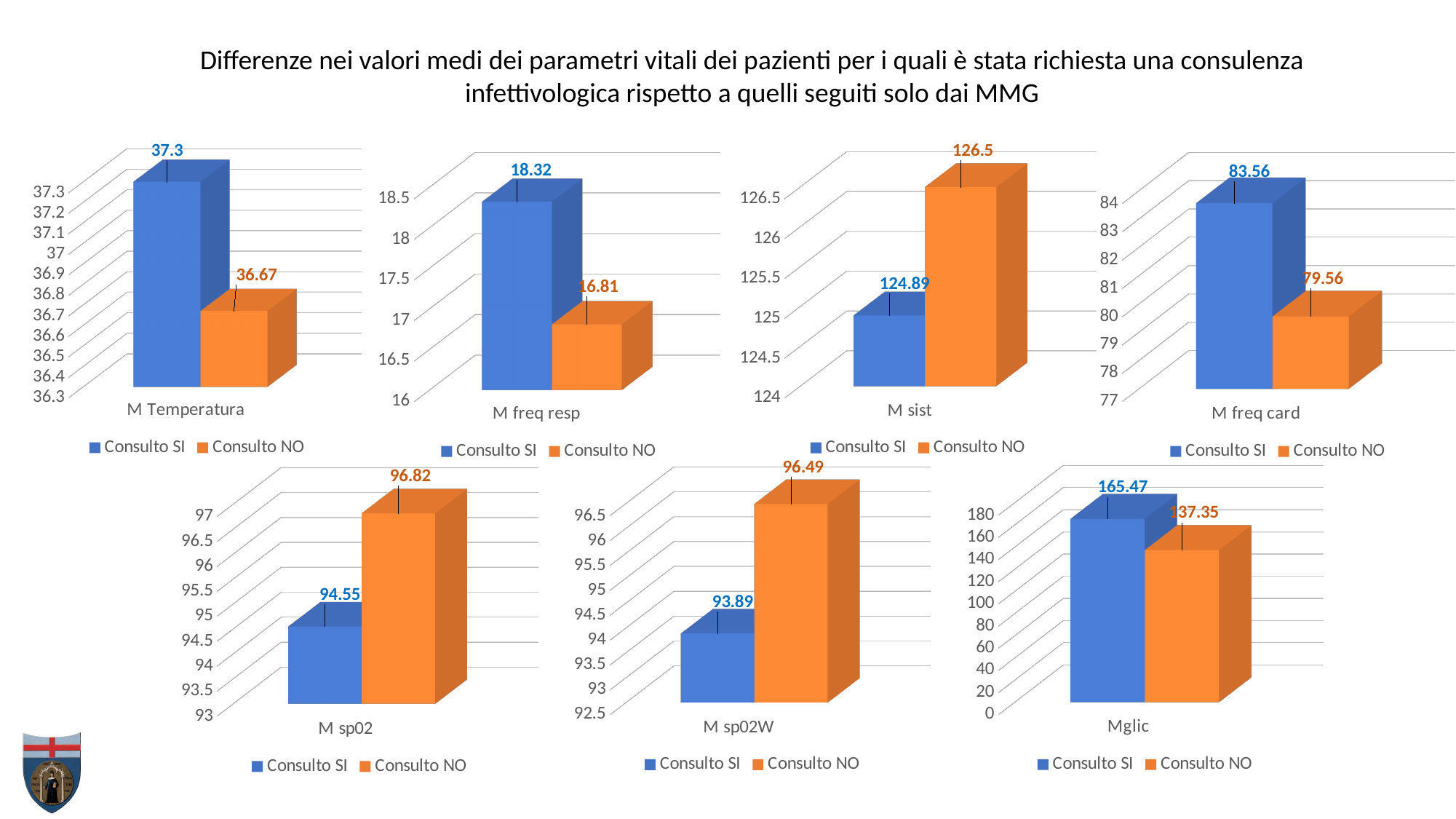
In the M freq card chart, what is the difference between Consulto SI and Consulto NO? 4 In the M Temperatura chart, what is the value for Consulto SI? 37.3 In the M sp02 chart, what is the value for Consulto NO? 96.82 What kind of chart is the M sist chart? Bar chart How many series does the legend of the M Temperatura chart list? 2 In the M sist chart, which series has the higher value, Consulto SI or Consulto NO? Consulto NO In the M freq resp chart, what is the value for Consulto NO? 16.81 In the M freq resp chart, is the value for Consulto SI greater or less than 18? greater How many charts are shown on the slide? 7 In the M sp02W chart, what is the value for Consulto SI? 93.89 In the Mglic chart, which series has the lower value? Consulto NO In the Mglic chart, what is the difference between Consulto SI and Consulto NO? 28.12